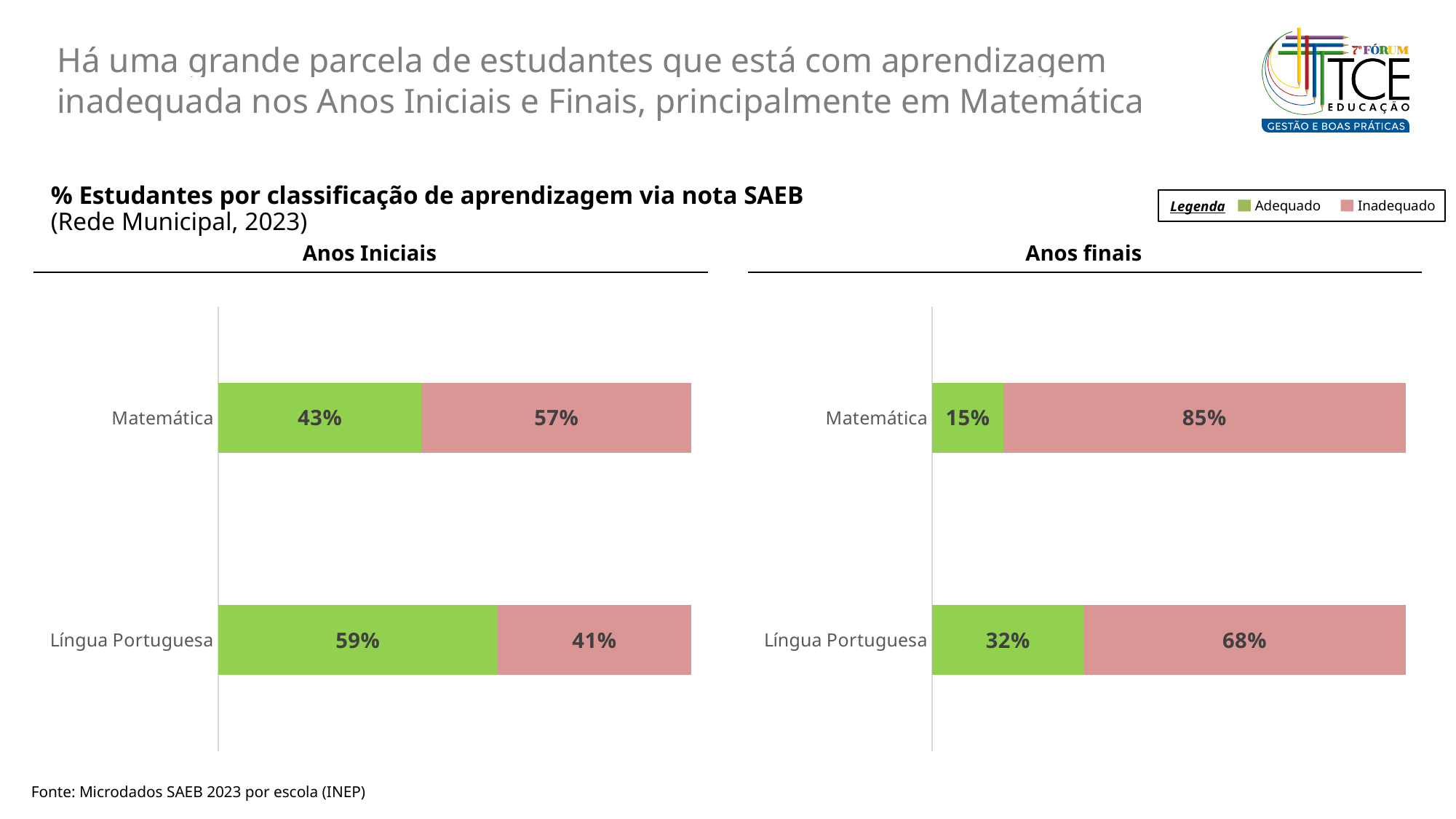
In the Anos finais chart, what is the Inadequado value for Matemática? 85% What kind of chart is used for Anos Iniciais? Stacked bar chart In the Anos Iniciais chart, what is the Adequado value for Matemática? 43% In the Anos finais chart, what is the total of the stacked bar for Língua Portuguesa? 100% In the Anos Iniciais chart, what is the Inadequado value for Língua Portuguesa? 41% In the Anos finais chart, what is the difference between the Inadequado values for Matemática and Língua Portuguesa? 17% How many series does the legend list? 2 In the Anos finais chart, what is the Adequado value for Língua Portuguesa? 32% In the Anos Iniciais chart, which category has the highest Inadequado value? Matemática Is the Adequado value for Matemática larger in the Anos Iniciais chart or in the Anos finais chart? Anos Iniciais In the Anos finais chart, which category has the lowest Adequado value? Matemática In the Anos Iniciais chart, what is the difference between the Adequado values for Língua Portuguesa and Matemática? 16%